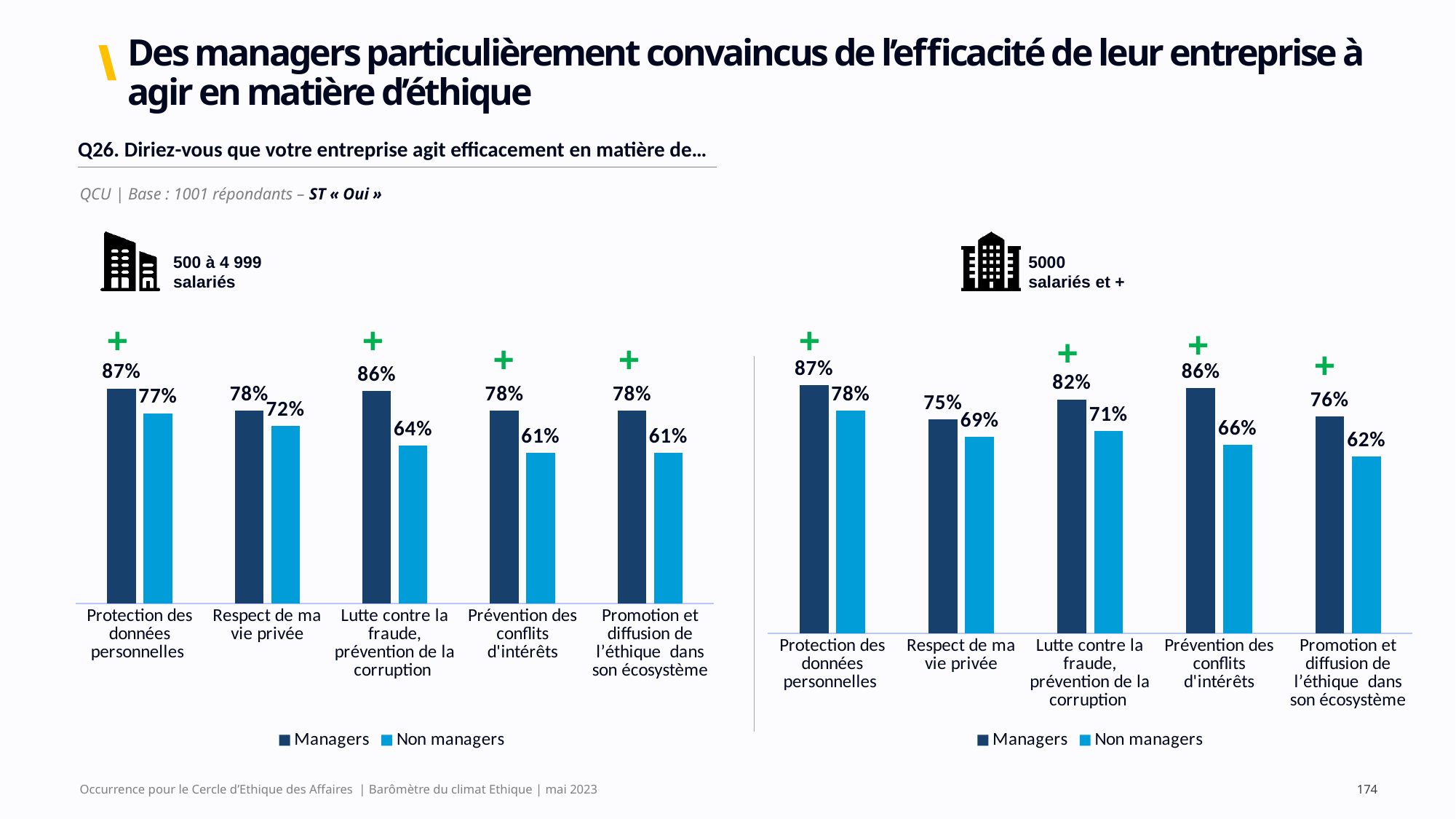
In the left chart (500 à 4 999 salariés), which category has the lowest Non managers value? Prévention des conflits d'intérêts and Promotion et diffusion de l'éthique dans son écosystème (both 61%) What kind of chart is the right chart (5000 salariés et +)? Bar chart In the right chart (5000 salariés et +), what is the value for Non managers on 'Respect de ma vie privée'? 69% In the left chart (500 à 4 999 salariés), what is the value for Non managers on 'Lutte contre la fraude, prévention de la corruption'? 64% In the left chart (500 à 4 999 salariés), what is the value for Managers on 'Protection des données personnelles'? 87% In the right chart (5000 salariés et +), what is the value for Managers on 'Promotion et diffusion de l'éthique dans son écosystème'? 76% In the left chart (500 à 4 999 salariés), what is the difference between Managers and Non managers on 'Lutte contre la fraude, prévention de la corruption'? 22 percentage points How many series does the legend of the left chart (500 à 4 999 salariés) list? 2 In the right chart (5000 salariés et +), which category has the highest Managers value? Protection des données personnelles How many categories are shown on the x axis of the right chart (5000 salariés et +)? 5 In the right chart (5000 salariés et +), what is the difference between Managers and Non managers on 'Prévention des conflits d'intérêts'? 20 percentage points In the left chart (500 à 4 999 salariés), which is larger: the Non managers value for 'Protection des données personnelles' or for 'Respect de ma vie privée'? Protection des données personnelles